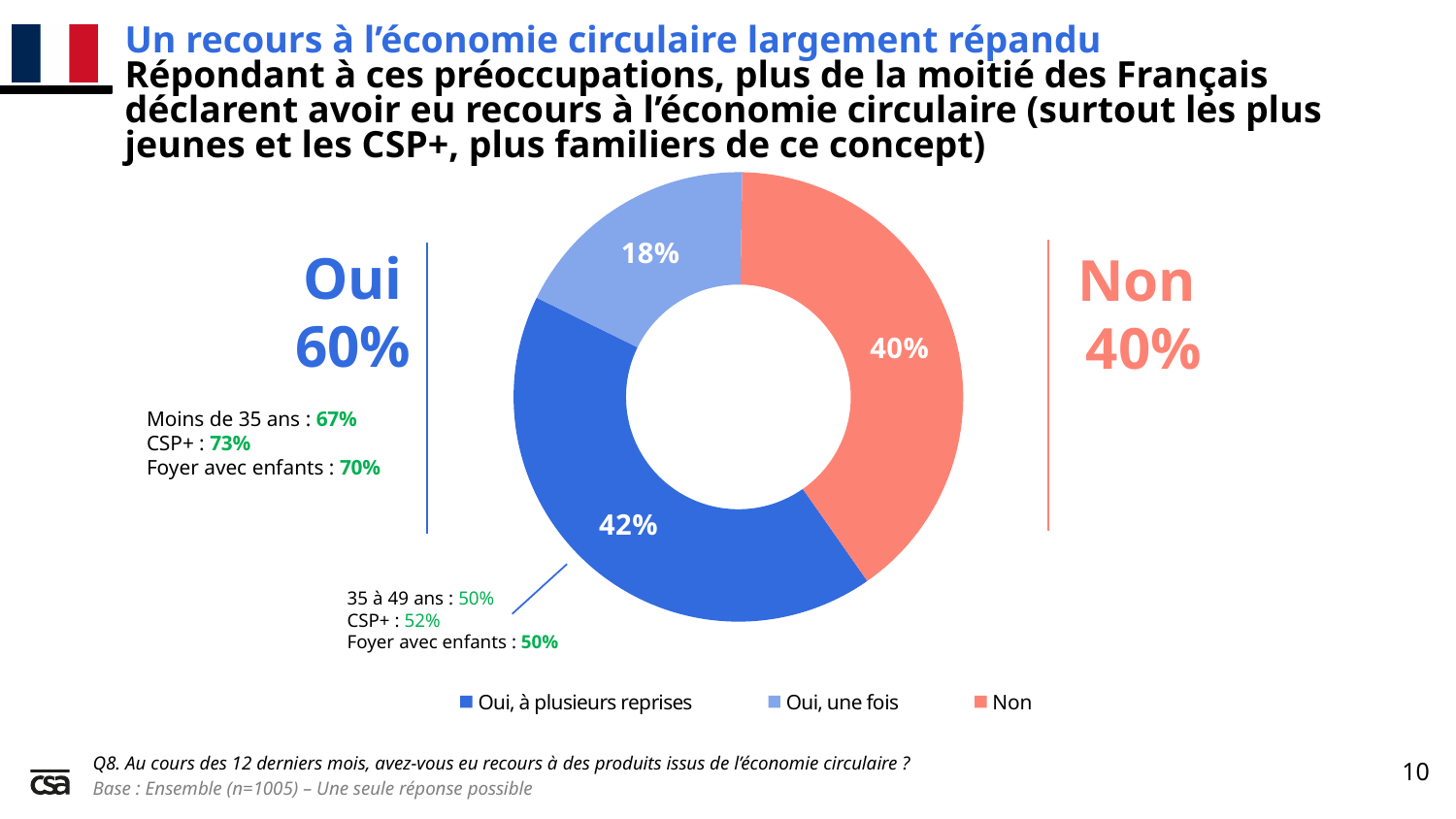
Which is larger: "Oui, une fois" or "Non"? Non What is the difference between "Oui, à plusieurs reprises" and "Non"? 2% Which category has the largest share of the chart? Oui, à plusieurs reprises How many categories does the legend list? 3 What is the value for "Non"? 40% What is the value for "Oui, à plusieurs reprises"? 42% What is the combined share of the two "Oui" categories? 60% What is the value for "Oui, une fois"? 18% What colour is the "Non" slice? Salmon / light red What kind of chart is shown on the slide? Doughnut (pie) chart Which category has the smallest share of the chart? Oui, une fois What is the difference between "Oui, à plusieurs reprises" and "Oui, une fois"? 24%